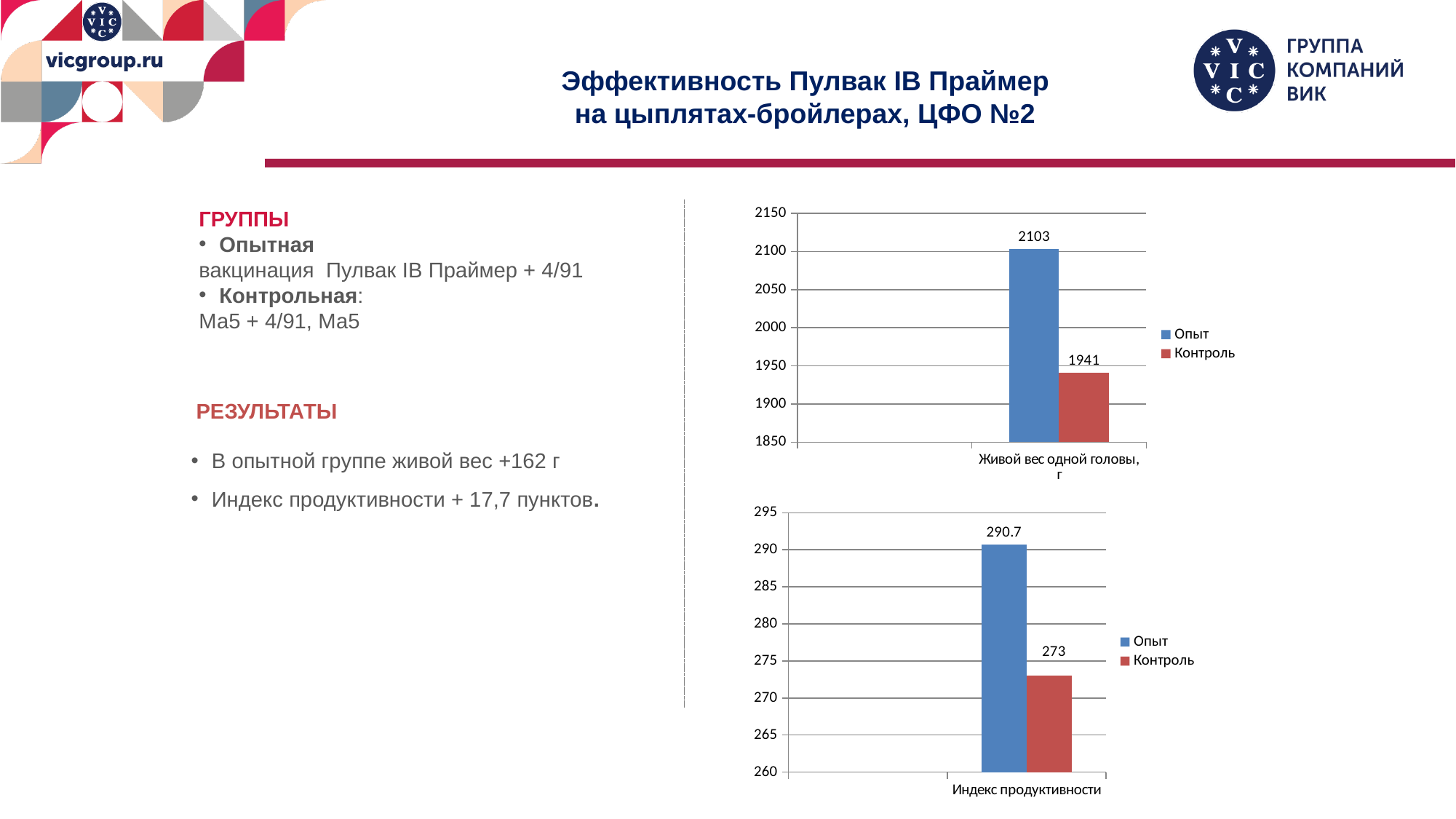
In the top chart (Живой вес одной головы, г), what is the value for Контроль? 1941 In the bottom chart (Индекс продуктивности), what is the value for Опыт? 290.7 In the bottom chart (Индекс продуктивности), what is the value for Контроль? 273 In the top chart (Живой вес одной головы, г), which series has the higher value, Опыт or Контроль? Опыт In the top chart (Живой вес одной головы, г), what is the difference between Опыт and Контроль? 162 In the bottom chart (Индекс продуктивности), which series has the lower value? Контроль In the top chart (Живой вес одной головы, г), is the value for Контроль greater or less than 2000? less In the bottom chart (Индекс продуктивности), what is the difference between Опыт and Контроль? 17.7 What kind of chart is the bottom chart (Индекс продуктивности)? bar chart In the bottom chart (Индекс продуктивности), is the value for Опыт greater or less than 285? greater In the top chart (Живой вес одной головы, г), what is the value for Опыт? 2103 How many series does the legend of the top chart list? 2